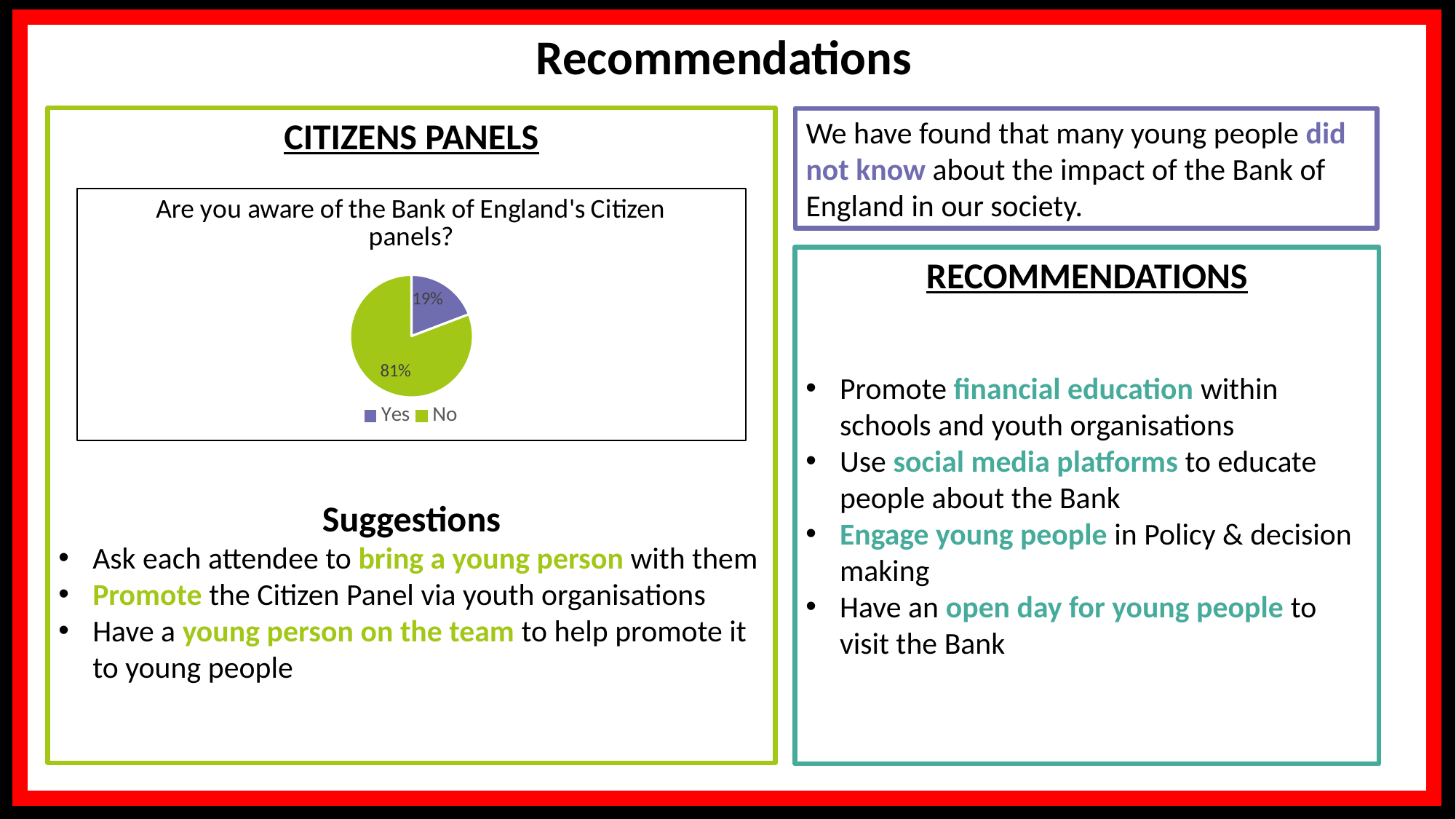
Which response has the smallest share of the pie? Yes What colour is the No slice in the pie chart? green Which is larger, the Yes slice or the No slice? No Which response has the largest share of the pie? No What share of the pie does the Yes slice represent? 19% What type of chart is shown on the slide? pie chart What percentage of respondents answered Yes? 19% How many slices does the pie chart have? 2 What percentage of respondents answered No? 81% What is the difference in percentage points between the No and Yes slices? 62 What is the title of the chart? Are you aware of the Bank of England's Citizen panels? How many entries does the legend list? 2